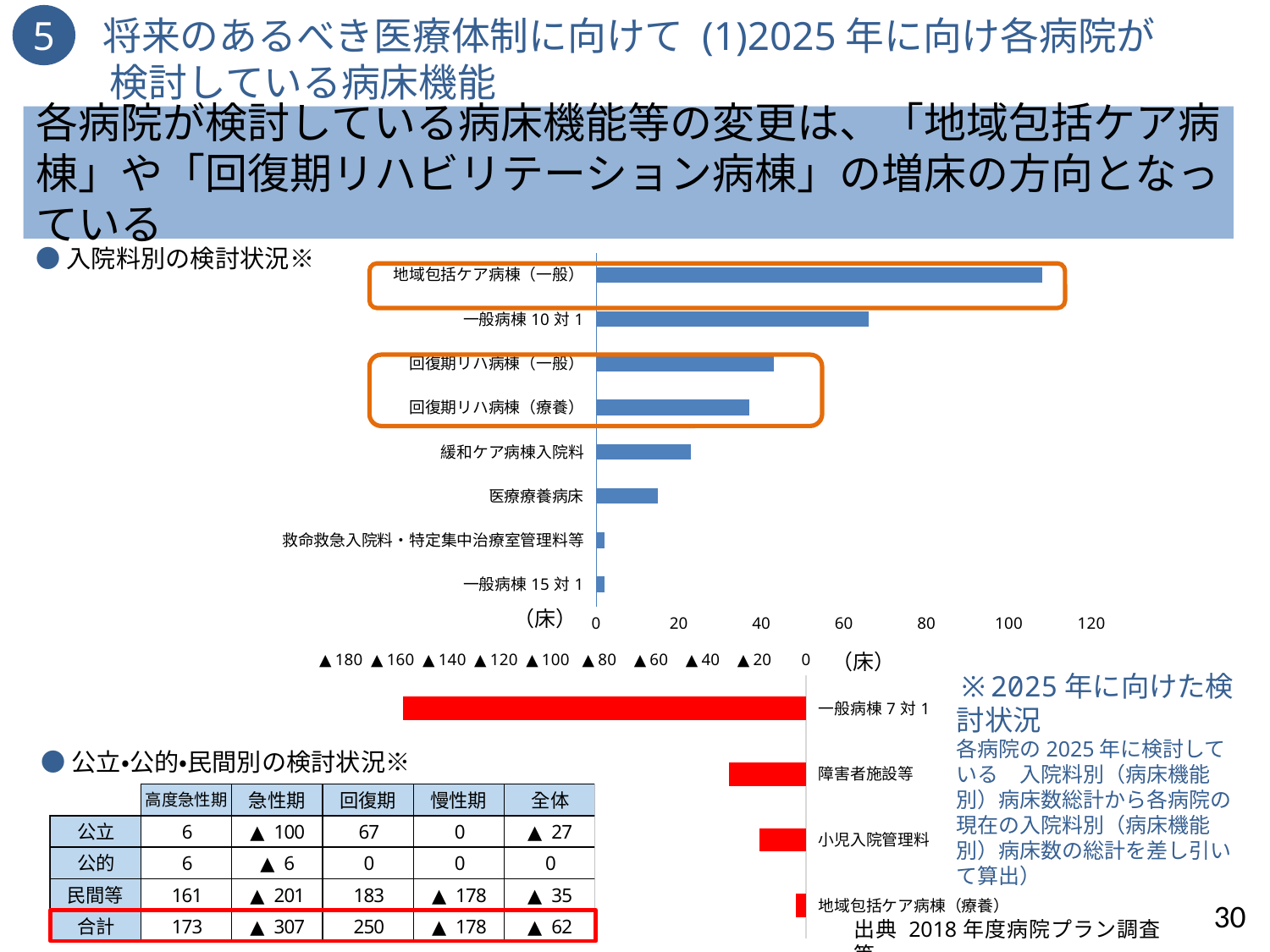
In the lower red bar chart, which category shows the smallest decrease (shortest bar)? 地域包括ケア病棟（療養） In the upper blue bar chart, which is larger: 緩和ケア病棟入院料 or 医療療養病床? 緩和ケア病棟入院料 What kind of chart is the upper chart (入院料別の検討状況)? bar chart In the upper blue bar chart, is the value for 地域包括ケア病棟（一般） greater or less than 100? greater In the upper blue bar chart, is the value for 一般病棟10対1 greater or less than 60? greater In the upper blue bar chart, which is larger: 一般病棟10対1 or 回復期リハ病棟（療養）? 一般病棟10対1 How many categories are plotted in the lower red bar chart? 4 In the upper blue bar chart, which category has the highest value? 地域包括ケア病棟（一般） In the lower red bar chart, which category shows the largest decrease (longest bar)? 一般病棟7対1 In the upper blue bar chart, is the value for 回復期リハ病棟（一般） greater or less than 60? less How many categories are plotted in the upper blue bar chart? 8